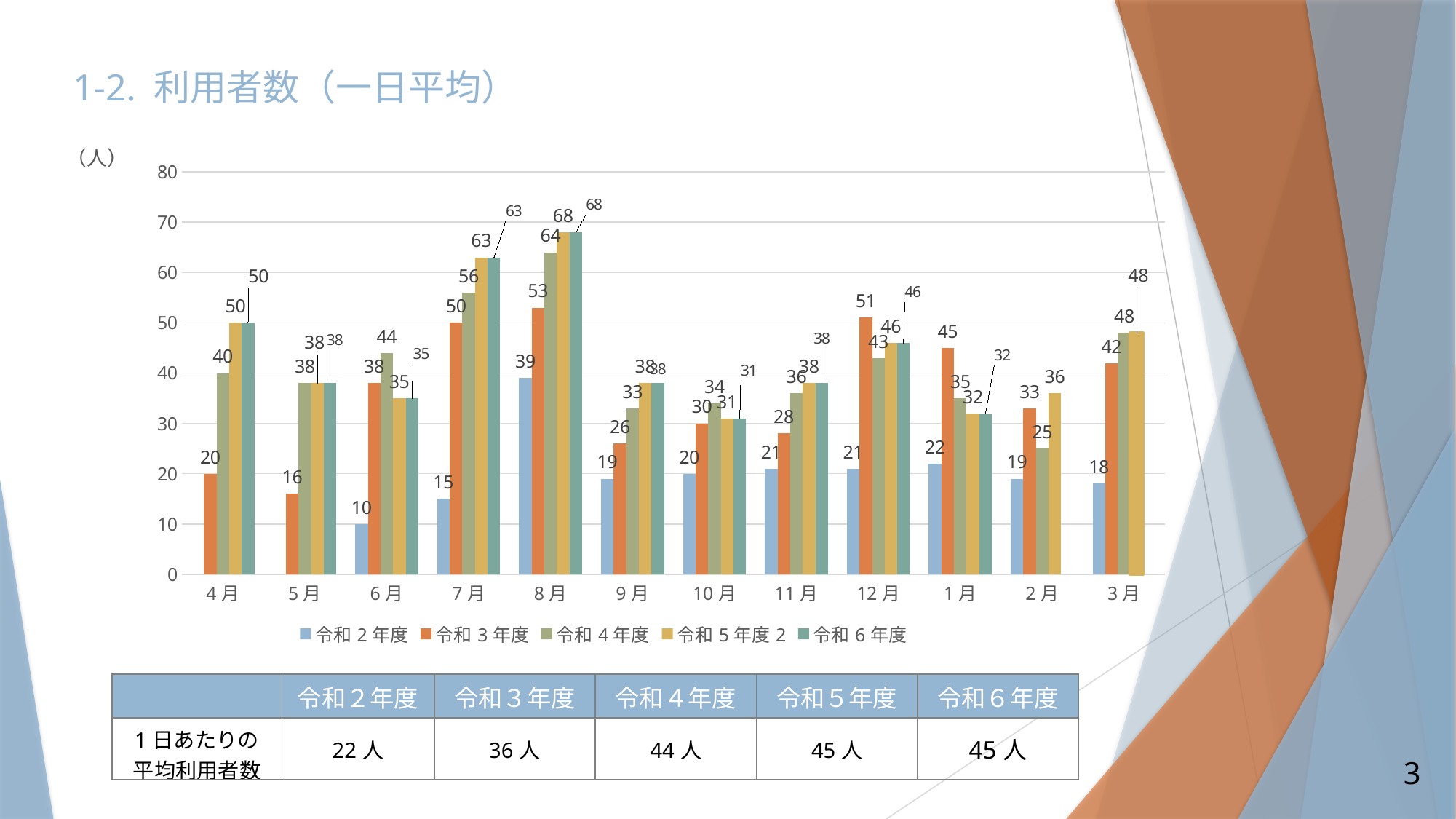
What kind of chart is shown on the slide? bar chart In which month is the 令和2年度 value lowest? 6月 What is the legend label of the yellow series? 令和5年度2 What is the value for 令和5年度2 in 7月? 63 How many months are shown along the x axis of the chart? 12 What is the value for 令和2年度 in 6月? 10 What is the difference between the 令和3年度 and 令和2年度 values in 12月? 30 What is the value for 令和3年度 in 8月? 53 In which month is the 令和4年度 value highest? 8月 What is the value for 令和6年度 in 11月? 38 How many series does the chart legend list? 5 In 1月, which is larger: the 令和3年度 value or the 令和4年度 value? 令和3年度